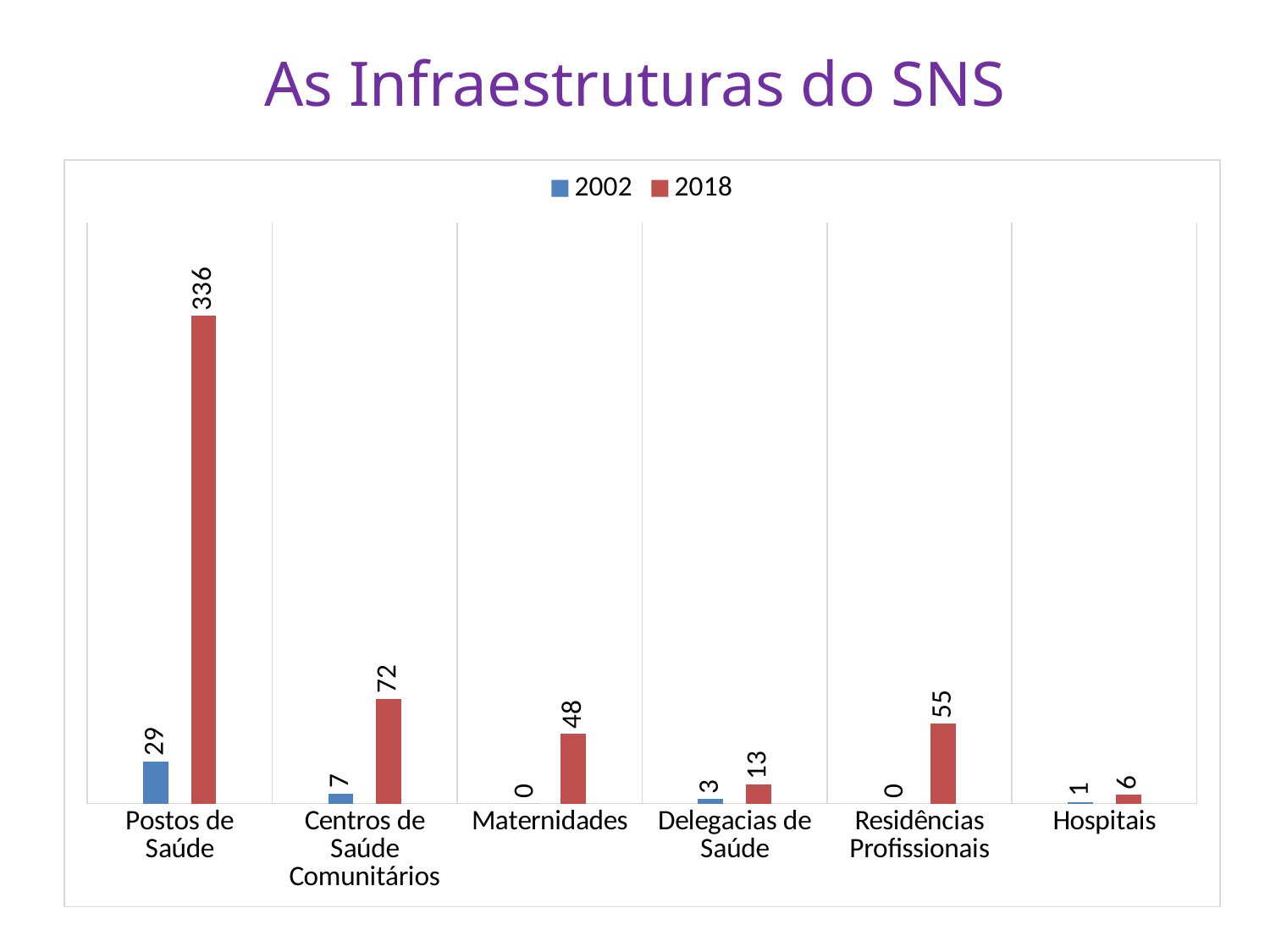
What is the difference between the 2018 and 2002 values for Postos de Saúde? 307 How many categories are shown on the x axis? 6 What is the value for Centros de Saúde Comunitários in 2002? 7 Which is larger: the 2018 value for Maternidades or the 2018 value for Residências Profissionais? Residências Profissionais What is the value for Maternidades in 2018? 48 What is the difference between the 2018 values for Centros de Saúde Comunitários and Residências Profissionais? 17 What kind of chart is shown on the slide? Bar chart What is the value for Hospitais in 2002? 1 Which category has the lowest value in 2018? Hospitais What is the value for Postos de Saúde in 2018? 336 How many series does the legend list? 2 Which category has the highest value in 2018? Postos de Saúde